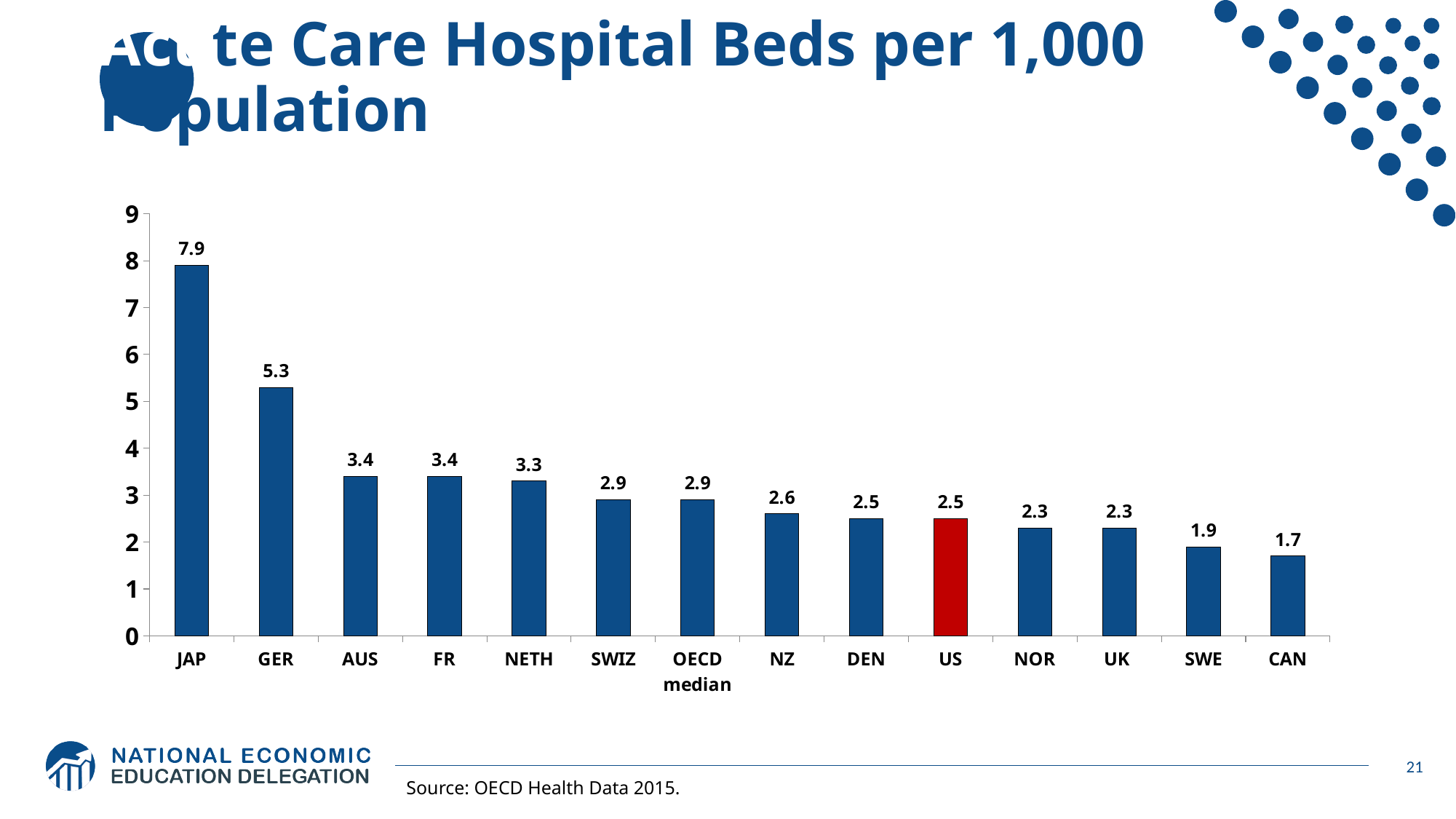
Is the value for GER greater or less than 5? greater How many bars are shown in the chart? 14 What is the difference between the OECD median and the US value? 0.4 What is the value for the OECD median? 2.9 Which has a larger value, NETH or SWIZ? NETH What is the value for JAP? 7.9 What is the value for the US? 2.5 What is the difference between the values for JAP and GER? 2.6 Which country has the highest number of acute care hospital beds per 1,000 population? JAP What kind of chart is shown on the slide? Bar chart Which bar is coloured red instead of blue? US Which country has the lowest number of acute care hospital beds per 1,000 population? CAN